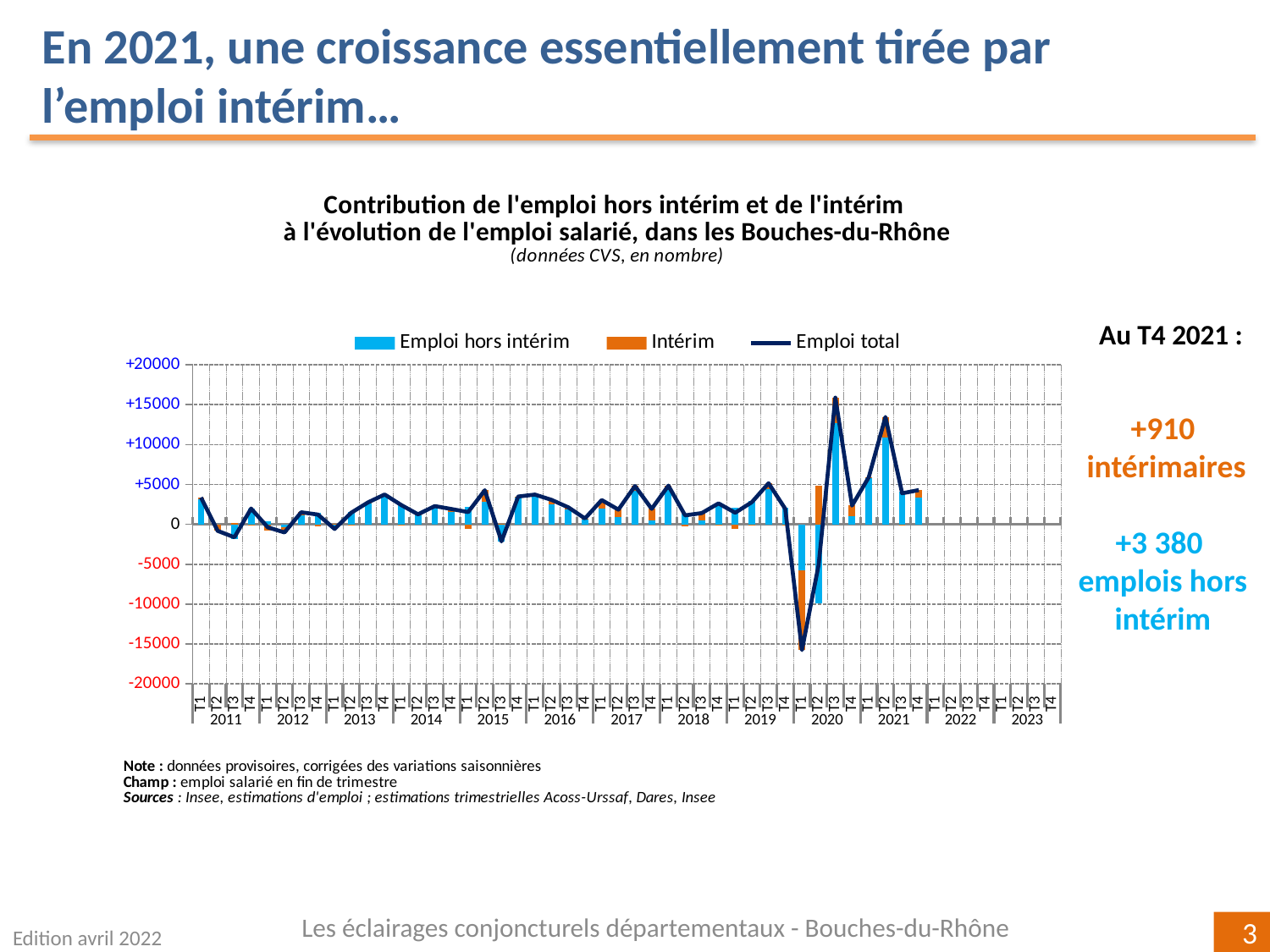
How many series does the chart legend list? 3 In which quarter does the Emploi total line reach its highest point? T3 2020 According to the slide, what is the value for Emploi hors intérim at T4 2021? +3 380 Which colour represents the Intérim series in the chart? Orange Which is larger, the Emploi total value at T3 2020 or at T2 2021? T3 2020 What kind of chart is shown on the slide? Combined bar and line chart In which quarter does the Emploi total line reach its lowest point? T1 2020 According to the slide, what is the value for Intérim at T4 2021? +910 Is the value of Emploi total at T2 2021 greater or less than 10000? greater What is the total of the stacked bar (Emploi hors intérim plus Intérim) at T4 2021? +4 290 Is the value of Emploi total at T1 2020 greater or less than -10000? less How many years are labelled along the x axis of the chart? 13